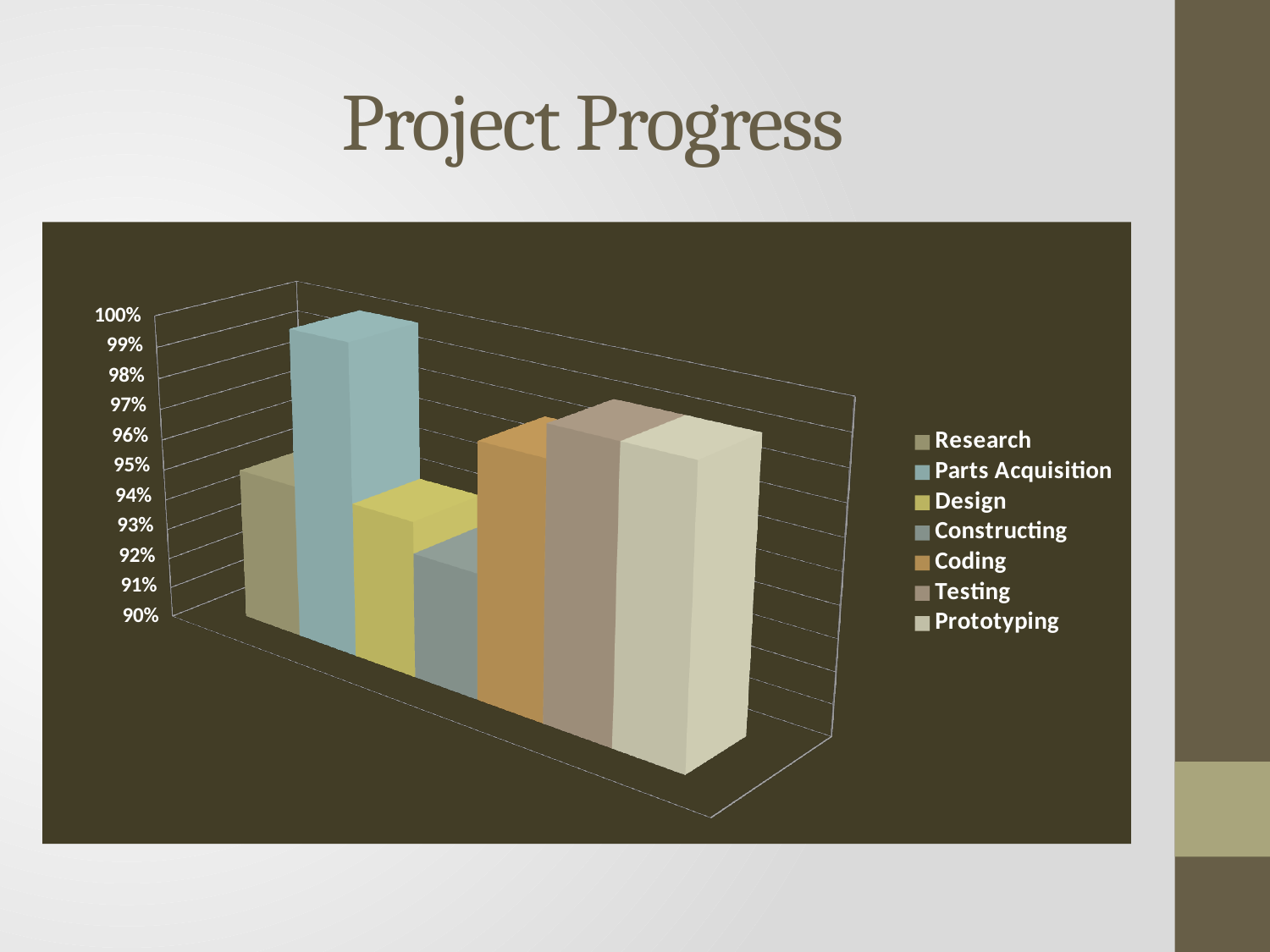
What is the title of the chart? Project Progress Which series has the lowest bar? Constructing What kind of chart is shown on the slide? bar chart Which series has the highest bar? Parts Acquisition What is the lowest value shown on the vertical axis? 90% Is the value for Testing greater or less than 95%? greater How many bars are plotted in the chart? 7 Which is larger, the value for Research or the value for Parts Acquisition? Parts Acquisition How many series does the legend list? 7 Which is larger, the value for Constructing or the value for Coding? Coding Is the value for Parts Acquisition greater or less than 95%? greater Is the value for Constructing greater or less than 95%? less